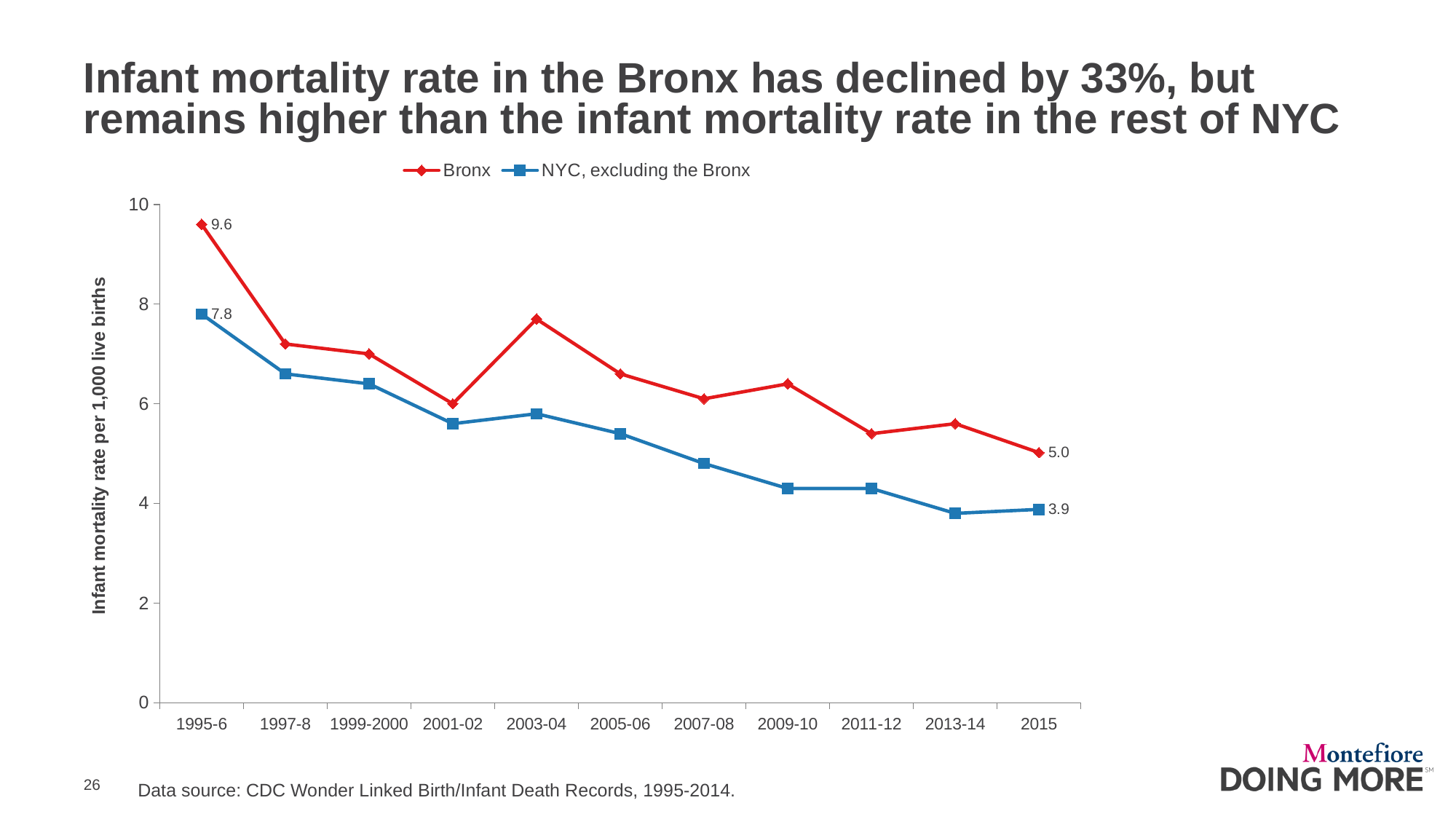
What kind of chart is shown on the slide? line chart How many time periods are shown on the x axis? 11 In 2015, what is the difference between the Bronx rate and the rate for NYC, excluding the Bronx? 1.1 What is the infant mortality rate for NYC, excluding the Bronx, in 2015? 3.9 Is the value for NYC, excluding the Bronx, in 2009-10 greater or less than 6? less What is the infant mortality rate for the Bronx in 1995-6? 9.6 What is the infant mortality rate for the Bronx in 2015? 5.0 In 1995-6, which series has the higher infant mortality rate, Bronx or NYC, excluding the Bronx? Bronx Is the Bronx value for 2003-04 greater or less than 6? greater What is the infant mortality rate for NYC, excluding the Bronx, in 1995-6? 7.8 By how much did the Bronx infant mortality rate fall between 1995-6 and 2015? 4.6 How many series does the legend list? 2